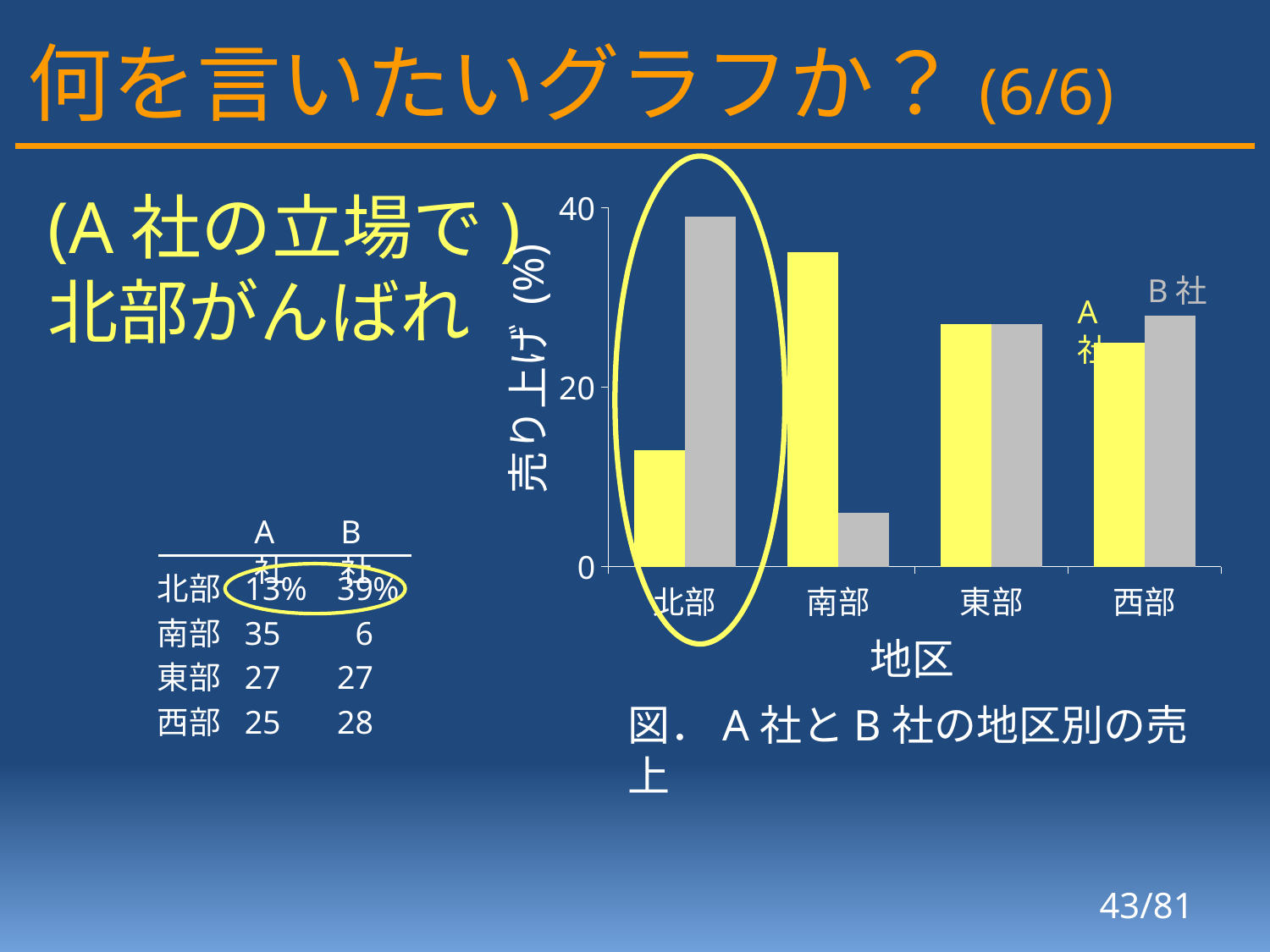
What is the value for B社 in 北部? 39% In 南部, which is larger, A社 or B社? A社 What is the difference between B社 and A社 in 北部? 26% Which region has the lowest value for B社? 南部 What is the value for A社 in 北部? 13% Which region has the highest value for A社? 南部 Is the value for B社 in 南部 greater or less than 20? less What is the label of the y axis of the chart? 売り上げ (%) Which region has the highest value for B社? 北部 What kind of chart is shown on the slide? bar chart How many series does the chart show? 2 How many regions (地区) are shown on the x axis of the chart? 4